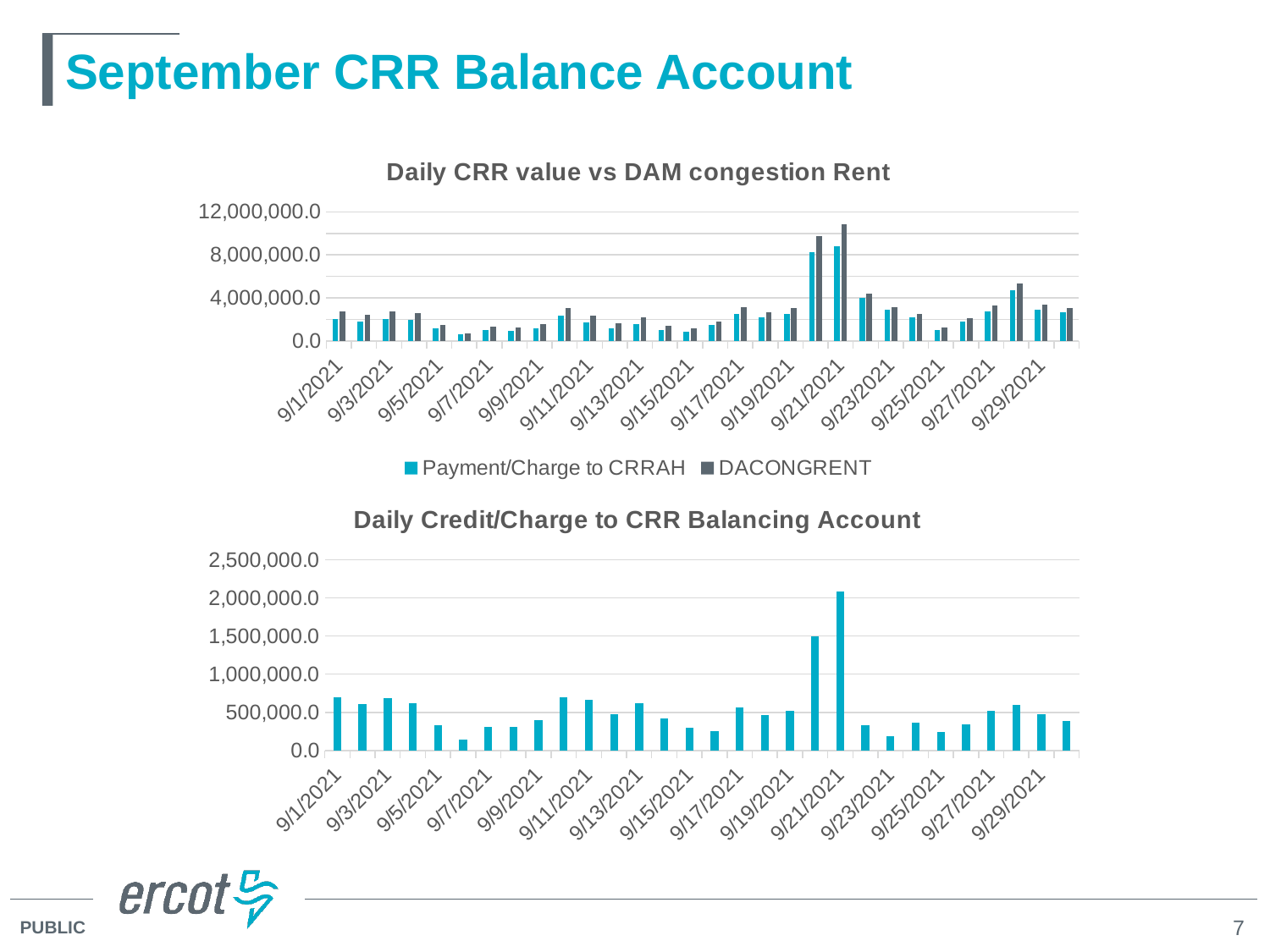
What are the two series named in the legend of the top chart, 'Daily CRR value vs DAM congestion Rent'? Payment/Charge to CRRAH and DACONGRENT How many series does the legend of the top chart, 'Daily CRR value vs DAM congestion Rent', list? 2 In the top chart, 'Daily CRR value vs DAM congestion Rent', which series has the larger value on 9/21/2021? DACONGRENT What is the title of the bottom chart on the slide? Daily Credit/Charge to CRR Balancing Account In the bottom chart, 'Daily Credit/Charge to CRR Balancing Account', is the value for 9/21/2021 greater or less than 1,500,000.0? greater In the bottom chart, 'Daily Credit/Charge to CRR Balancing Account', on which date is the value highest? 9/21/2021 In the top chart, 'Daily CRR value vs DAM congestion Rent', is the Payment/Charge to CRRAH value for 9/7/2021 greater or less than 4,000,000.0? less In the bottom chart, 'Daily Credit/Charge to CRR Balancing Account', is the value for 9/7/2021 greater or less than 500,000.0? less In the bottom chart, 'Daily Credit/Charge to CRR Balancing Account', which date has the larger value, 9/1/2021 or 9/7/2021? 9/1/2021 What kind of chart is the top chart, 'Daily CRR value vs DAM congestion Rent'? Bar chart In the top chart, 'Daily CRR value vs DAM congestion Rent', on which date is the DACONGRENT value highest? 9/21/2021